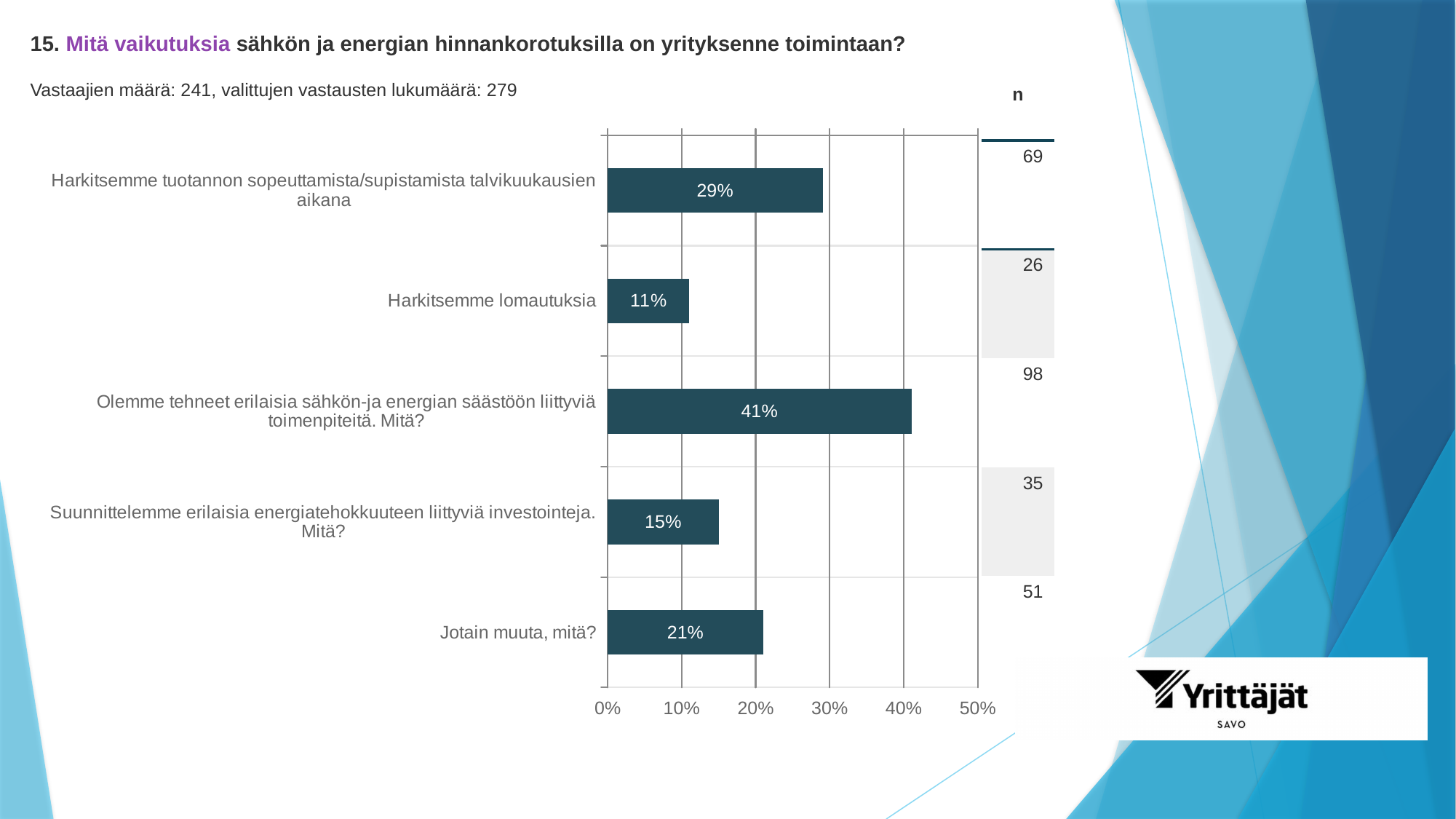
Which category has the lowest percentage? Harkitsemme lomautuksia What is the difference in percentage points between "Harkitsemme tuotannon sopeuttamista/supistamista talvikuukausien aikana" and "Harkitsemme lomautuksia"? 18 percentage points How many categories are shown in the chart? 5 What is the n value for "Suunnittelemme erilaisia energiatehokkuuteen liittyviä investointeja. Mitä?"? 35 What percentage is shown for "Jotain muuta, mitä?"? 21% How many respondents (Vastaajien määrä) are stated on the slide? 241 What is the highest value shown on the x axis? 50% Which category has the highest percentage? Olemme tehneet erilaisia sähkön-ja energian säästöön liittyviä toimenpiteitä. Mitä? What percentage is shown for "Harkitsemme lomautuksia"? 11% What is the n value for "Olemme tehneet erilaisia sähkön-ja energian säästöön liittyviä toimenpiteitä. Mitä?"? 98 Which is larger: the percentage for "Jotain muuta, mitä?" or for "Suunnittelemme erilaisia energiatehokkuuteen liittyviä investointeja. Mitä?"? Jotain muuta, mitä? What kind of chart is shown on the slide? Bar chart